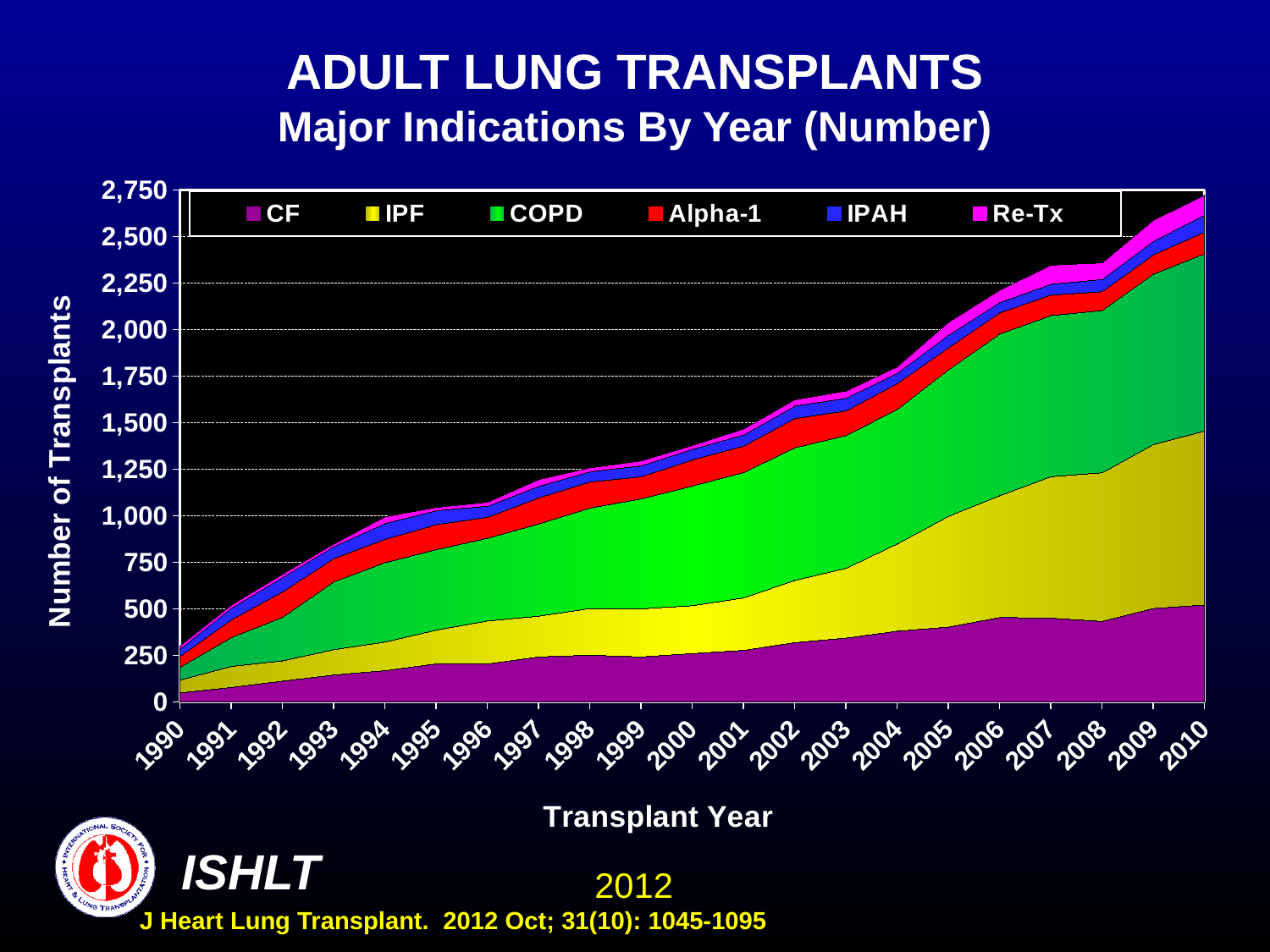
Is the total number of transplants in 1990 greater or less than 500? less How many series does the legend list? 6 How many transplant years are shown along the x axis? 21 Is the total number of transplants in 2010 greater or less than 2,500? greater Is the total number of transplants in 1993 greater or less than 750? greater Does the total number of transplants rise or fall from 1990 to 2010? rise Which indication is shown in green in the legend? COPD What is the last year shown on the x axis? 2010 What kind of chart is shown on the slide? stacked area chart What is the first year shown on the x axis? 1990